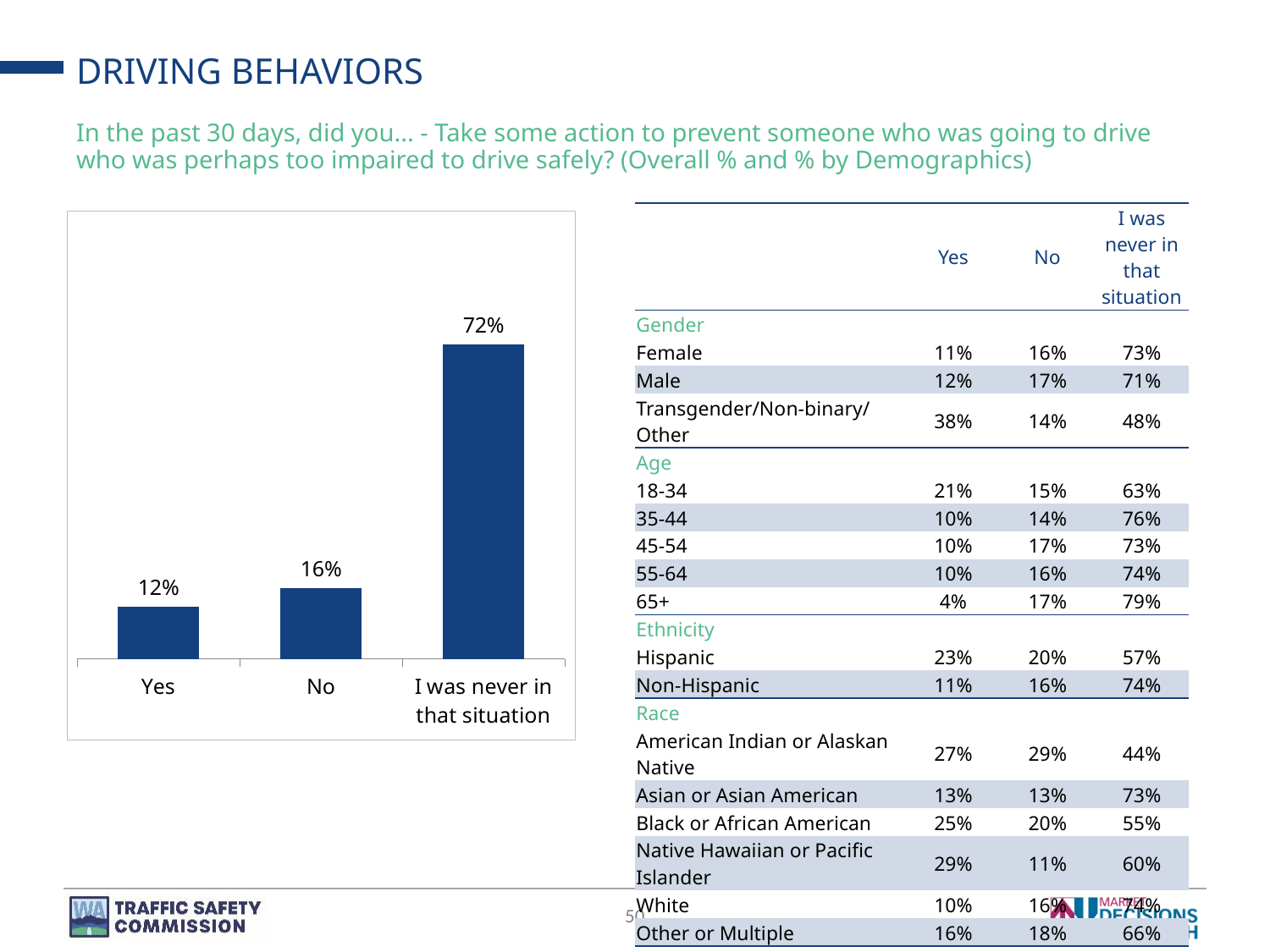
What is the difference between the values for "I was never in that situation" and "No" in the bar chart? 56% Which category has the lowest value in the bar chart? Yes What is the difference between the values for "No" and "Yes" in the bar chart? 4% What is the value for "Yes" in the bar chart? 12% What is the value for "No" in the bar chart? 16% Do the values in the bar chart rise or fall from left to right? Rise Which category has the highest value in the bar chart? I was never in that situation In the bar chart, which is larger: the value for "Yes" or the value for "No"? No What colour are the bars in the chart? Dark blue How many categories are shown in the bar chart? 3 What is the value for "I was never in that situation" in the bar chart? 72% What kind of chart is shown on the slide? Bar chart